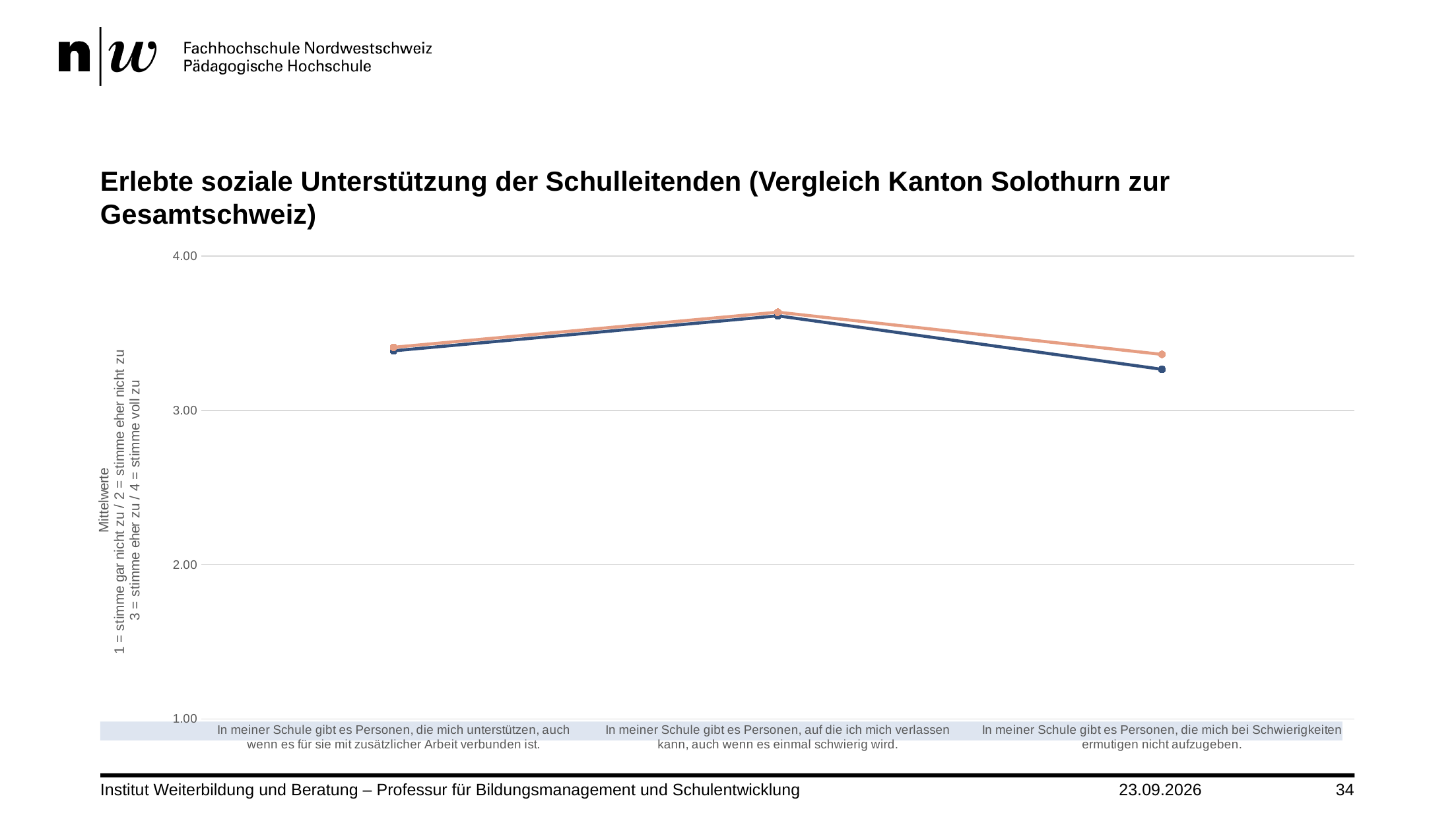
Is the value for "In meiner Schule gibt es Personen, die mich unterstützen, auch wenn es für sie mit zusätzlicher Arbeit verbunden ist." greater or less than 3.00 for the blue line? greater Which category has the highest value for the blue line? In meiner Schule gibt es Personen, auf die ich mich verlassen kann, auch wenn es einmal schwierig wird. Is the value for "In meiner Schule gibt es Personen, auf die ich mich verlassen kann, auch wenn es einmal schwierig wird." greater or less than 3.00 for the orange line? greater Do the values of the blue line rise or fall from the second category to the third category? fall How many lines are plotted in the chart? 2 How many categories are shown on the x axis of the chart? 3 What kind of chart is shown on the slide? line chart For the third category, "In meiner Schule gibt es Personen, die mich bei Schwierigkeiten ermutigen nicht aufzugeben.", which line has the higher value, the orange or the blue? orange For the orange line, which is larger: the value for "In meiner Schule gibt es Personen, auf die ich mich verlassen kann, auch wenn es einmal schwierig wird." or the value for "In meiner Schule gibt es Personen, die mich bei Schwierigkeiten ermutigen nicht aufzugeben."? In meiner Schule gibt es Personen, auf die ich mich verlassen kann, auch wenn es einmal schwierig wird. What is the title of the chart on the slide? Erlebte soziale Unterstützung der Schulleitenden (Vergleich Kanton Solothurn zur Gesamtschweiz) Is the value for "In meiner Schule gibt es Personen, die mich bei Schwierigkeiten ermutigen nicht aufzugeben." greater or less than 4.00 for the blue line? less Which category has the lowest value for the blue line? In meiner Schule gibt es Personen, die mich bei Schwierigkeiten ermutigen nicht aufzugeben.